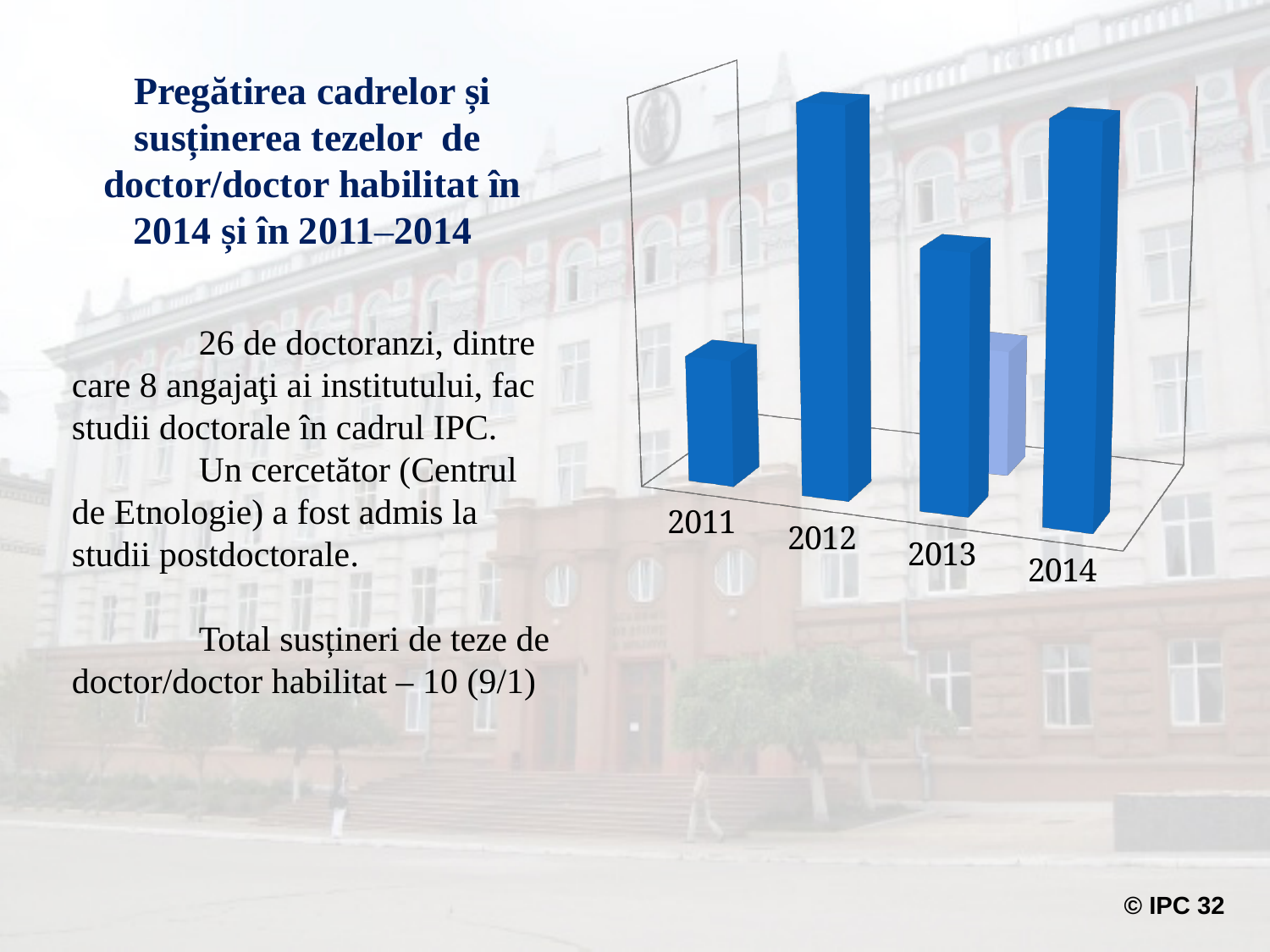
Which is larger in the chart, the bar for 2011 or the bar for 2012? 2012 Which is larger in the chart, the bar for 2013 or the bar for 2014? 2014 How many years are shown on the x axis of the chart? 4 Does the value rise or fall from 2012 to 2013 in the chart? fall What is the first year shown on the x axis of the chart? 2011 Does the value rise or fall from 2011 to 2012 in the chart? rise Does the value rise or fall from 2013 to 2014 in the chart? rise What kind of chart is shown on the slide? bar chart What is the last year shown on the x axis of the chart? 2014 Which is larger in the chart, the bar for 2012 or the bar for 2013? 2012